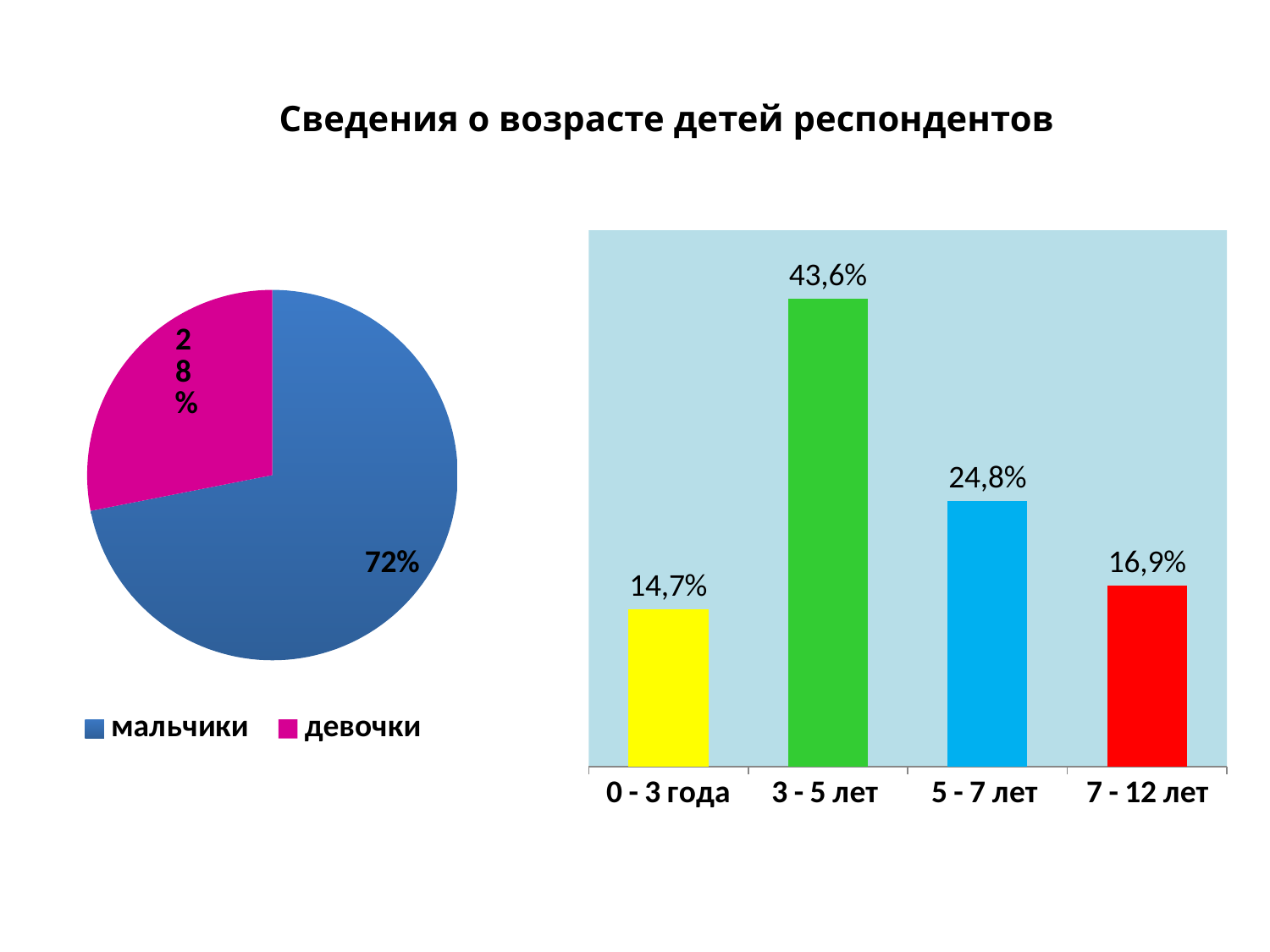
In the pie chart on the left, what share is labelled for мальчики? 72% In the bar chart on the right, what is the value for 3 - 5 лет? 43,6% What kind of chart is shown on the right side of the slide? bar chart In the pie chart on the left, which slice is larger, мальчики or девочки? мальчики In the bar chart on the right, how many age groups are shown? 4 In the pie chart on the left, how many entries does the legend list? 2 In the bar chart on the right, what is the value for 7 - 12 лет? 16,9% In the bar chart on the right, which age group has the lowest value? 0 - 3 года In the bar chart on the right, what is the difference between the values for 3 - 5 лет and 5 - 7 лет? 18,8% In the pie chart on the left, what is the difference between the мальчики and девочки shares? 44% In the bar chart on the right, which age group has the highest value? 3 - 5 лет In the pie chart on the left, what share is labelled for девочки? 28%